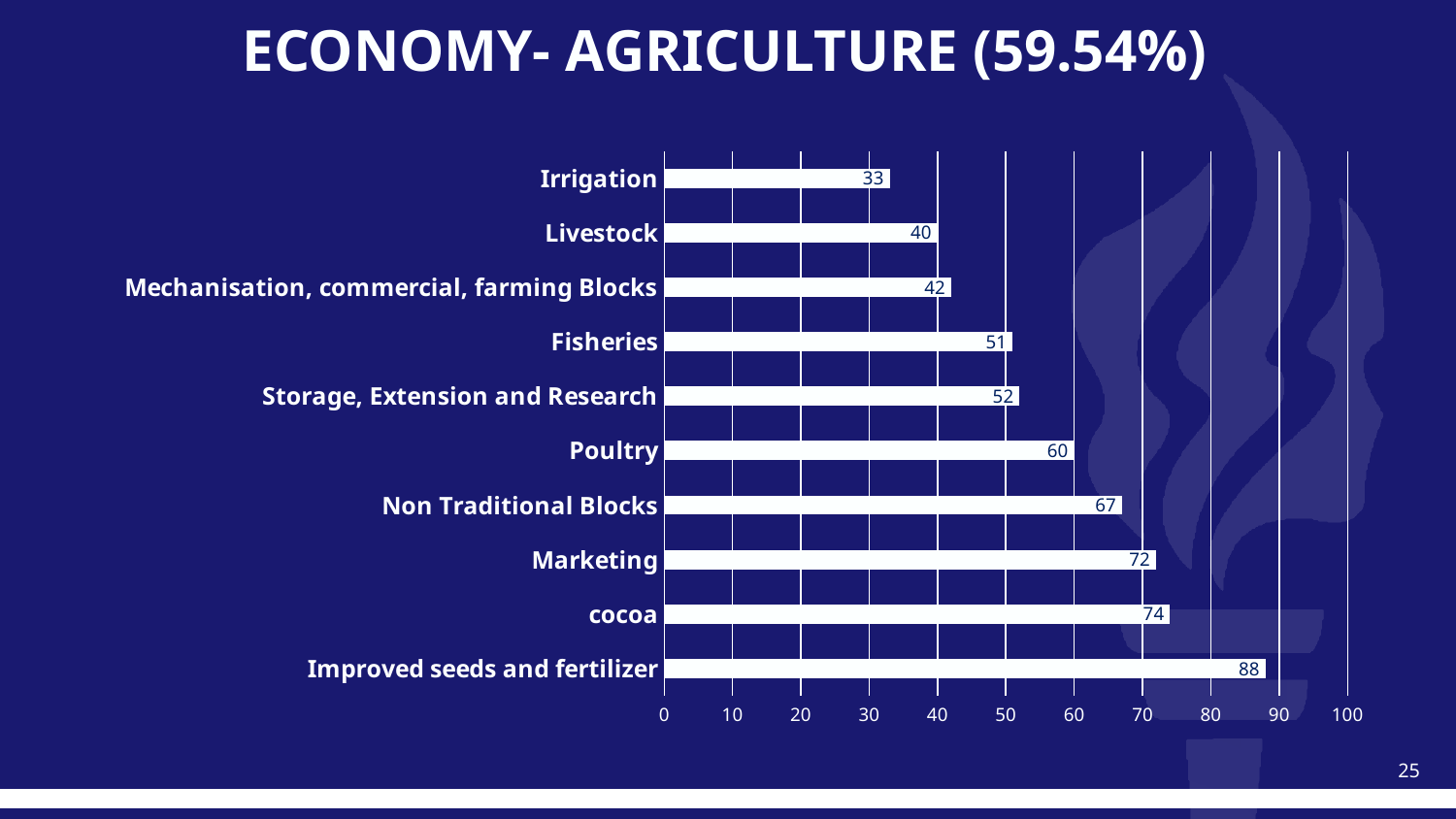
What is the title of the slide containing the chart? ECONOMY- AGRICULTURE (59.54%) What is the difference between the values for cocoa and Marketing? 2 How many categories are shown in the chart? 10 Which category has the lowest value? Irrigation What is the value for Irrigation? 33 What kind of chart is shown on the slide? Bar chart Which category has the highest value? Improved seeds and fertilizer What is the value for Storage, Extension and Research? 52 What is the value for Poultry? 60 Is the value for Non Traditional Blocks greater or less than 70? less Which is larger, the value for Fisheries or the value for Livestock? Fisheries What is the difference between the values for Improved seeds and fertilizer and Irrigation? 55